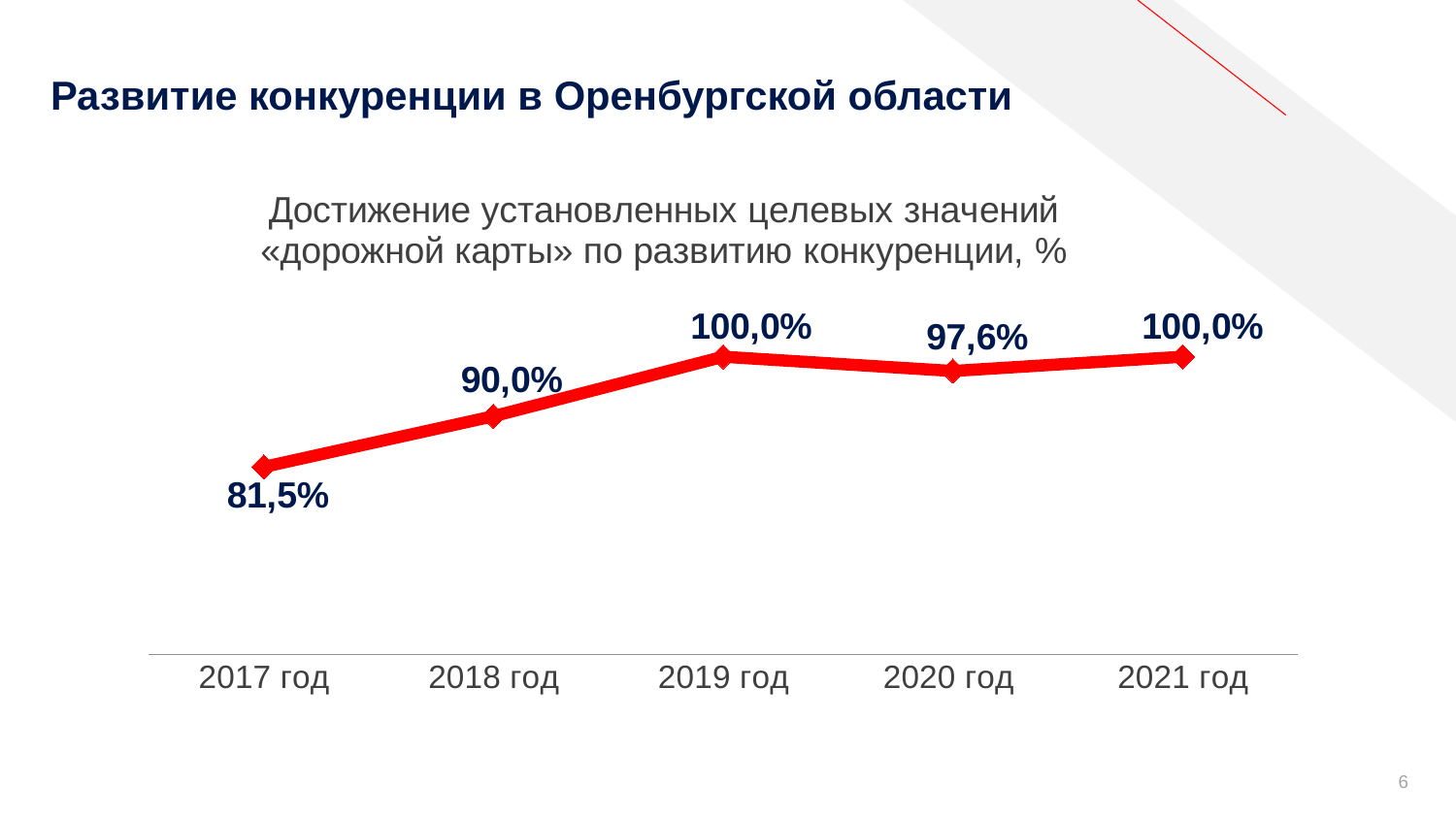
What is the title of the chart? Достижение установленных целевых значений «дорожной карты» по развитию конкуренции, % What is the difference between the values for 2019 год and 2020 год? 2,4% Which is larger, the value for 2020 год or the value for 2021 год? 2021 год What kind of chart is shown? line chart What is the value for 2017 год? 81,5% What is the difference between the values for 2018 год and 2017 год? 8,5% What is the value for 2021 год? 100,0% Which year has the lowest value? 2017 год What is the value for 2018 год? 90,0% What is the value for 2020 год? 97,6% Do the values generally rise or fall from 2017 год to 2019 год? rise How many years are plotted on the chart? 5